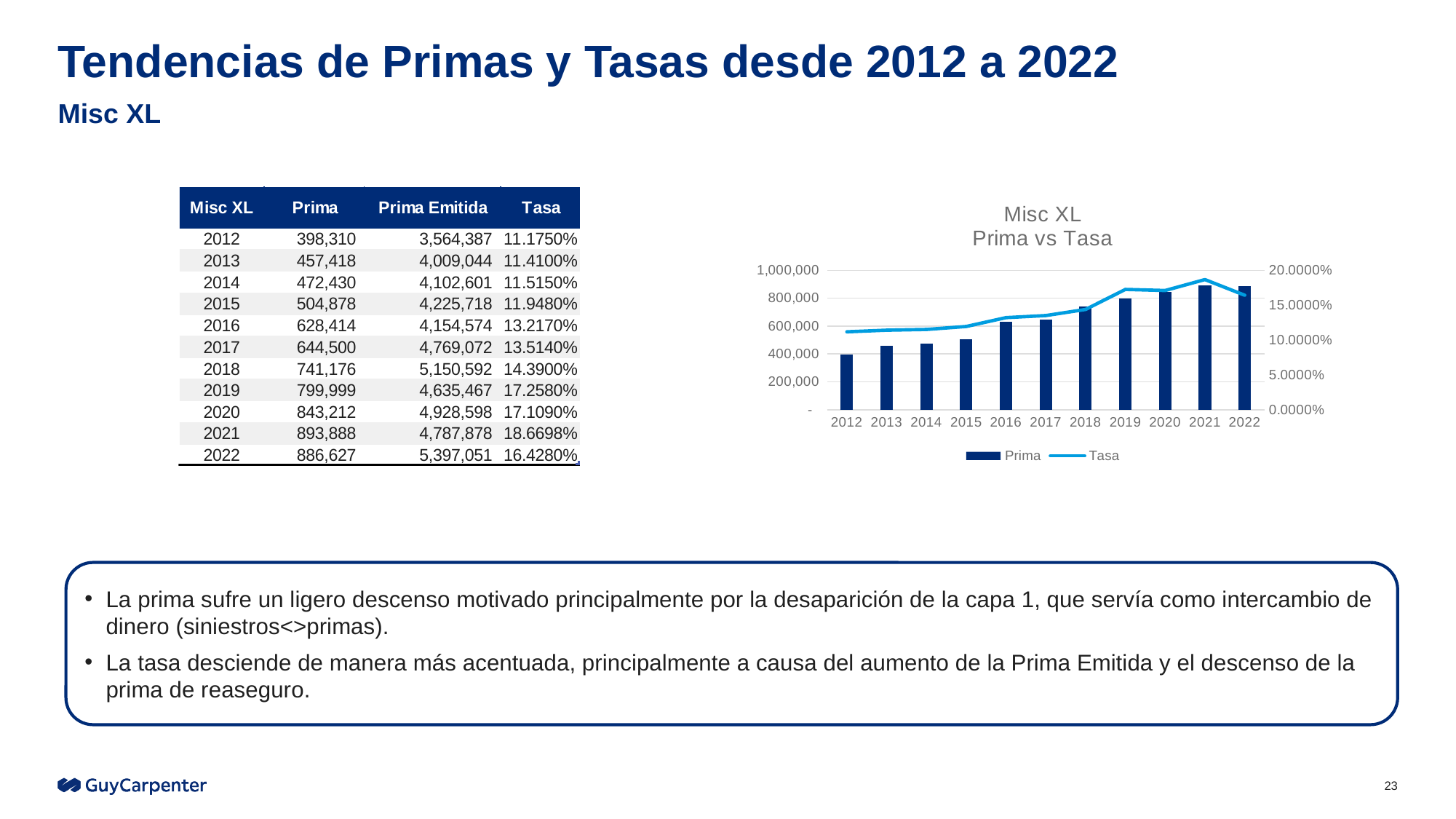
Does the Tasa line generally rise or fall from 2012 to 2021? rise What kind of chart is shown on the slide? A combined bar and line chart How many series does the chart legend list? 2 Is the Prima bar for 2018 taller or shorter than the Prima bar for 2015? taller What is the title of the chart? Misc XL Prima vs Tasa Which year has the lowest Prima bar in the chart? 2012 Is the Prima value for 2021 greater or less than 800,000? greater Is the Tasa value for 2016 greater or less than 15.0000%? less Which year has the highest Prima bar in the chart? 2021 Which series is drawn as a line in the chart? Tasa How many years are plotted on the x axis of the chart? 11 Is the Prima value for 2012 greater or less than 400,000? less